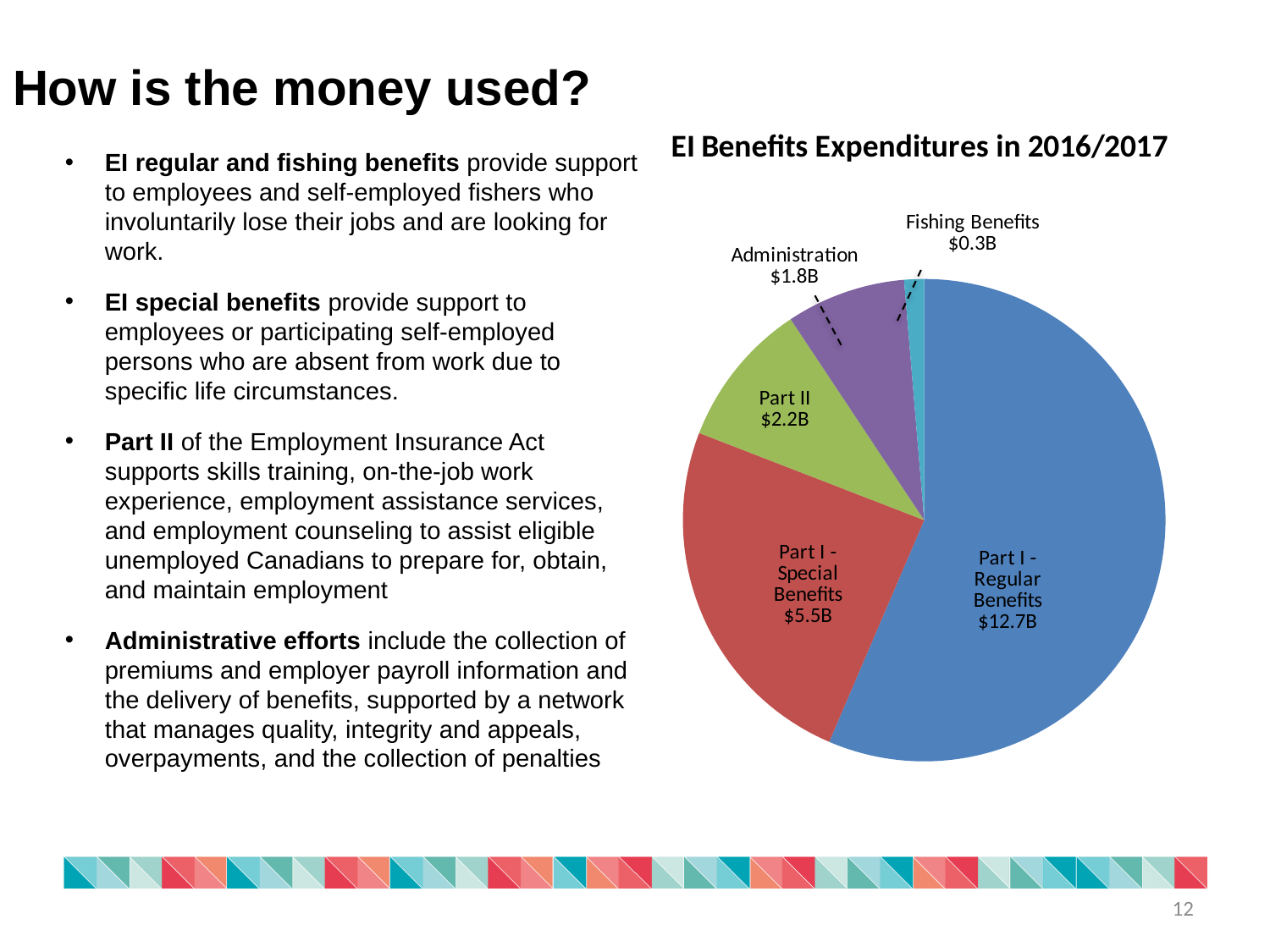
Which is larger, Part II or Administration? Part II What kind of chart is shown on the slide? Pie chart Which category has the largest expenditure? Part I - Regular Benefits What is the value for Part I - Special Benefits? $5.5B What is the value for Part I - Regular Benefits? $12.7B What is the value for Fishing Benefits? $0.3B How many slices does the pie chart have? 5 Which category has the smallest expenditure? Fishing Benefits What is the value for Administration? $1.8B What is the value for Part II? $2.2B What is the difference between Part I - Regular Benefits and Part I - Special Benefits? $7.2B What is the title of the chart? EI Benefits Expenditures in 2016/2017